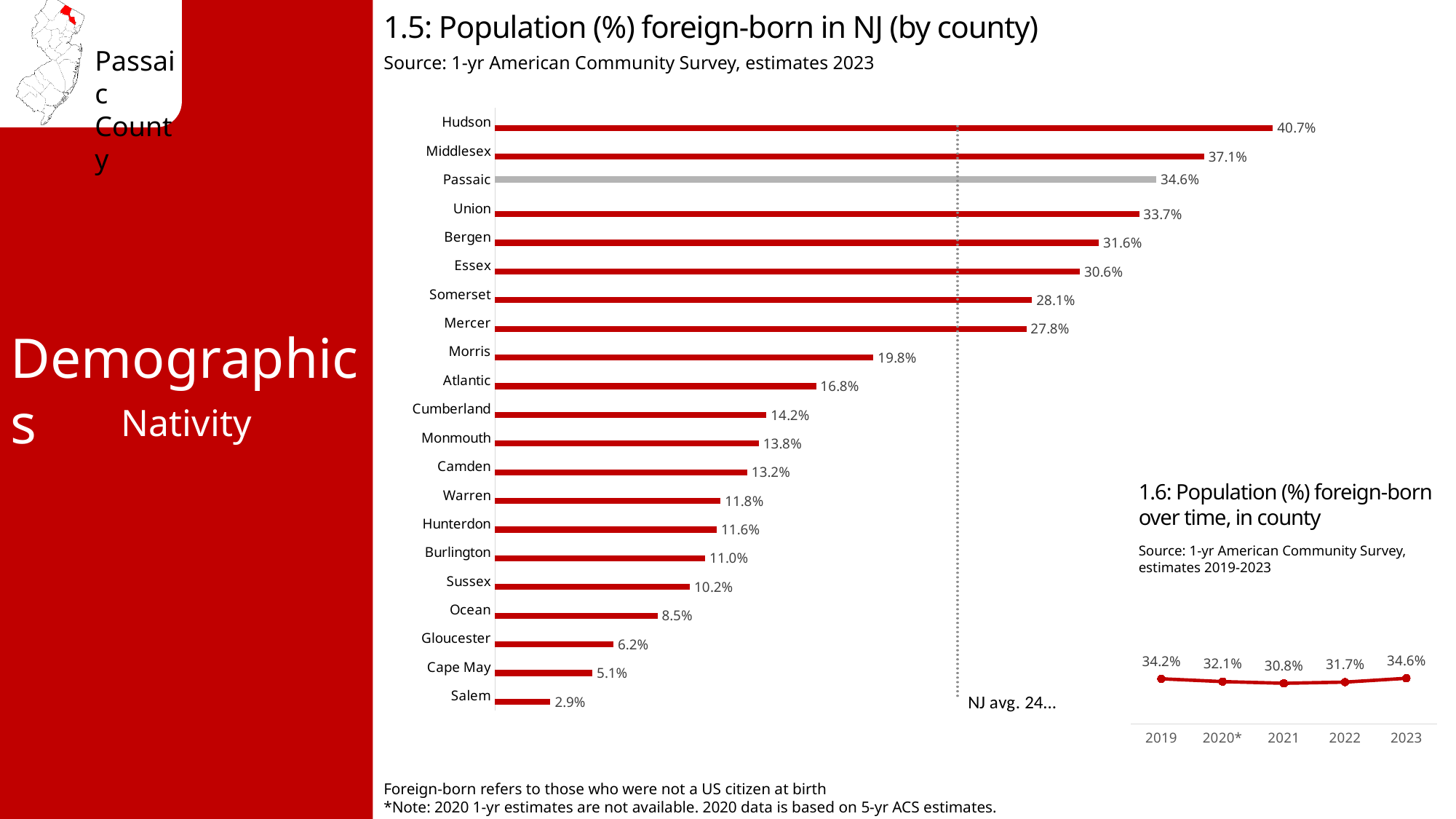
In chart 1.6 (Population (%) foreign-born over time, in county), how many years are plotted? 5 In chart 1.6 (Population (%) foreign-born over time, in county), which year has the lowest value? 2021 What kind of chart is chart 1.5 (Population (%) foreign-born in NJ by county)? Bar chart In chart 1.6 (Population (%) foreign-born over time, in county), what is the difference between 2023 and 2022? 2.9% In chart 1.5 (Population (%) foreign-born in NJ by county), which county has the lowest value? Salem In chart 1.5 (Population (%) foreign-born in NJ by county), which is larger, Bergen or Essex? Bergen In chart 1.5 (Population (%) foreign-born in NJ by county), what is the value for Passaic? 34.6% In chart 1.5 (Population (%) foreign-born in NJ by county), which county has the highest value? Hudson In chart 1.5 (Population (%) foreign-born in NJ by county), what is the value for Morris? 19.8% In chart 1.6 (Population (%) foreign-born over time, in county), what is the value for 2021? 30.8% In chart 1.5 (Population (%) foreign-born in NJ by county), what is the difference between Hudson and Passaic? 6.1% In chart 1.5 (Population (%) foreign-born in NJ by county), how many counties are shown? 21